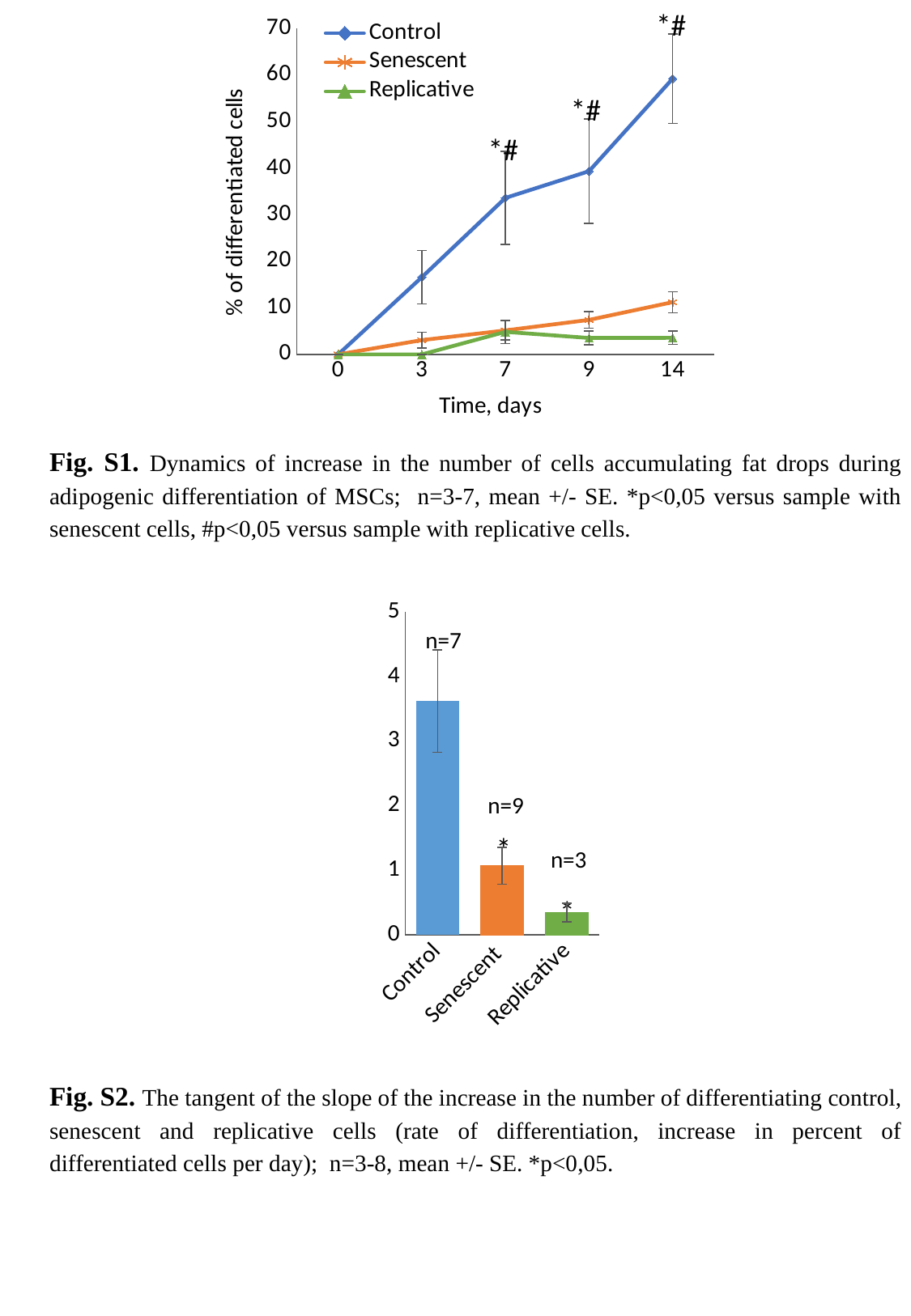
In the top chart (Fig. S1), how many series does the legend list? 3 In the bottom chart (Fig. S2), which category has the highest bar? Control In the top chart (Fig. S1), what is the x-axis label? Time, days In the top chart (Fig. S1), which series has the highest value at day 14? Control In the top chart (Fig. S1), how many time points are shown on the x axis? 5 In the bottom chart (Fig. S2), which category has the lowest bar? Replicative In the bottom chart (Fig. S2), what kind of chart is it? bar chart In the bottom chart (Fig. S2), is the value for Control greater or less than 3? greater In the top chart (Fig. S1), does the Control series rise or fall from day 0 to day 14? rises In the top chart (Fig. S1), is the Control value at day 14 greater or less than 50? greater In the top chart (Fig. S1), is the Replicative value at day 14 greater or less than 10? less In the top chart (Fig. S1), what kind of chart is it? line chart